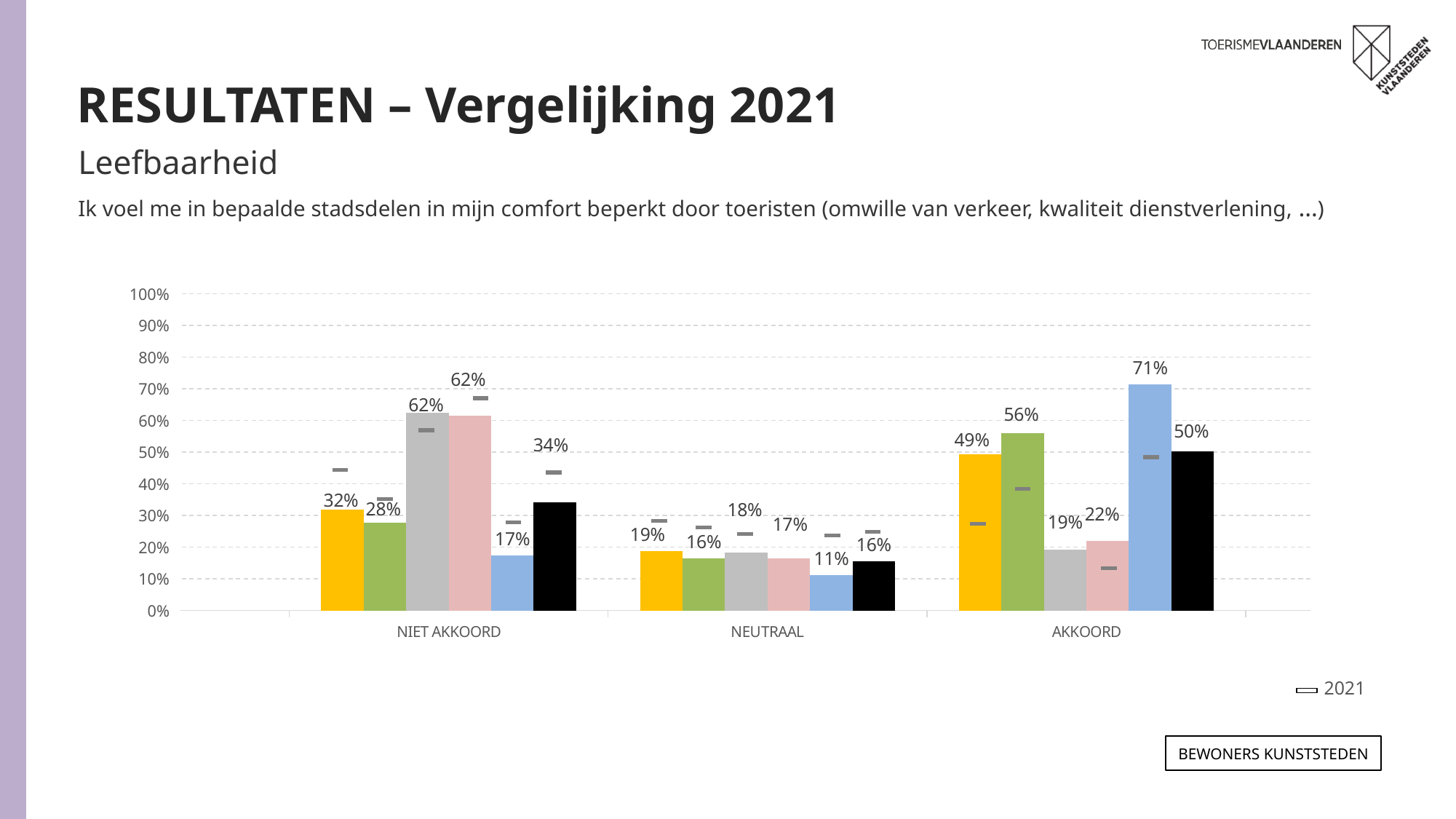
What is the only entry listed in the chart legend? 2021 What kind of chart is shown on the slide? bar chart Which is larger for AKKOORD: the yellow bar or the black bar? the black bar What is the value of the yellow bar for NIET AKKOORD? 32% Is the value of the grey bar for NIET AKKOORD greater or less than 50%? greater What is the value of the blue bar for AKKOORD? 71% What is the value of the black bar for NEUTRAAL? 16% Which category has the lowest value for the yellow bar? NEUTRAAL What is the value of the green bar for AKKOORD? 56% How many categories are shown on the x axis? 3 What is the difference between the blue bar for AKKOORD and the blue bar for NIET AKKOORD? 54% Which category has the highest value for the blue bar? AKKOORD